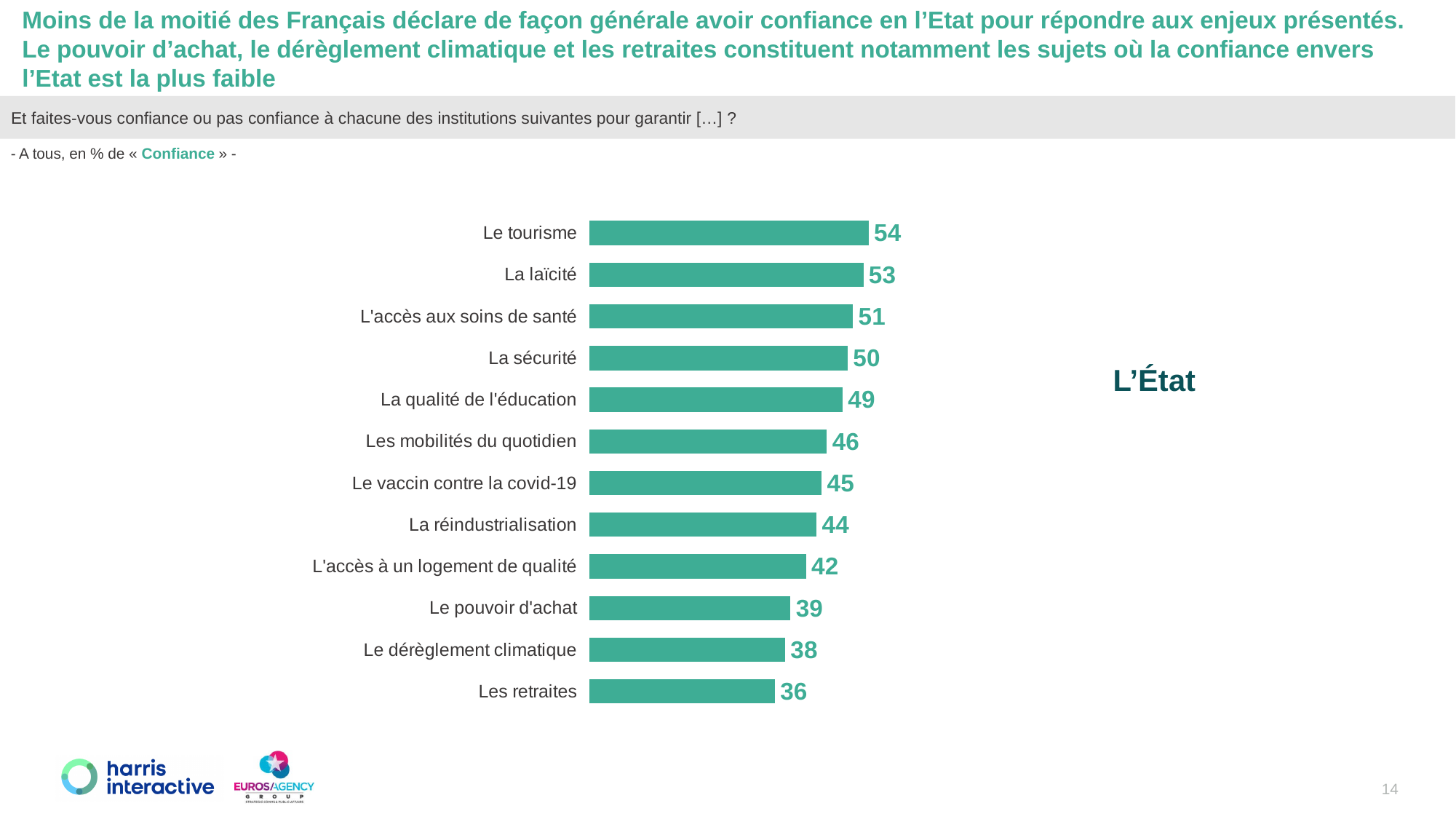
What kind of chart is shown on the slide? Bar chart Which category has the highest value? Le tourisme What is the value for La qualité de l'éducation? 49 What is the value for Le pouvoir d'achat? 39 Which institution does the chart refer to, as labelled next to it? L'État Which is larger, the value for La laïcité or the value for La réindustrialisation? La laïcité What is the difference between the values for Le tourisme and Les retraites? 18 How many categories are shown in the chart? 12 Which is larger, the value for Les mobilités du quotidien or the value for L'accès à un logement de qualité? Les mobilités du quotidien What is the value for Le tourisme? 54 What is the difference between the values for La sécurité and Le dérèglement climatique? 12 Which category has the lowest value? Les retraites